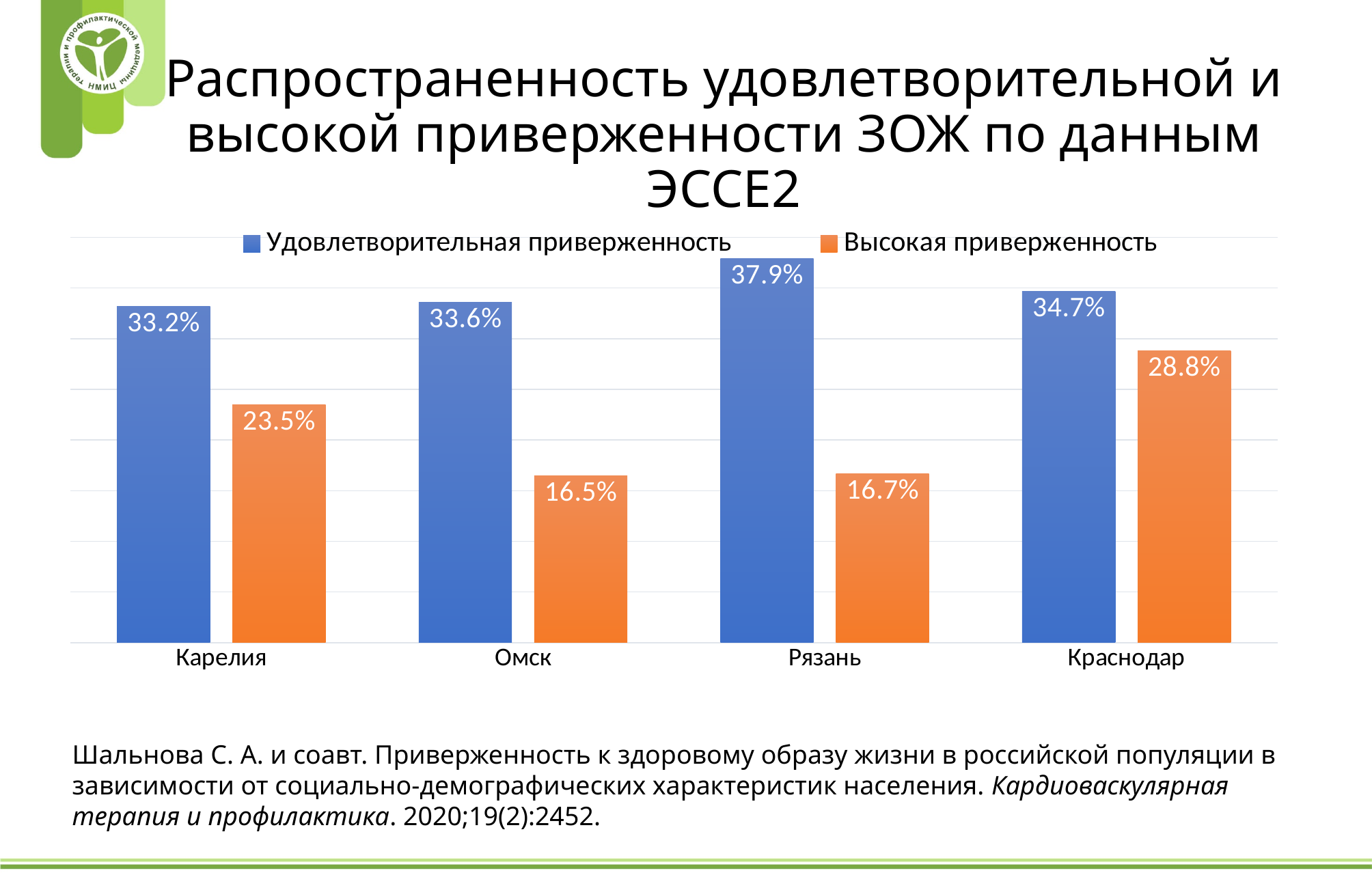
Which is larger: Высокая приверженность for Карелия or for Краснодар? Краснодар How many series does the legend list? 2 What is the value of Удовлетворительная приверженность for Рязань? 37.9% How many regions are shown on the x axis? 4 Which region has the highest value for Удовлетворительная приверженность? Рязань Which colour represents Высокая приверженность in the legend? Orange What kind of chart is shown on the slide? Bar chart Which region has the lowest value for Высокая приверженность? Омск What is the value of Высокая приверженность for Краснодар? 28.8% What is the value of Высокая приверженность for Омск? 16.5% What is the difference in Высокая приверженность between Краснодар and Рязань? 12.1% What is the difference between Удовлетворительная приверженность and Высокая приверженность for Карелия? 9.7%